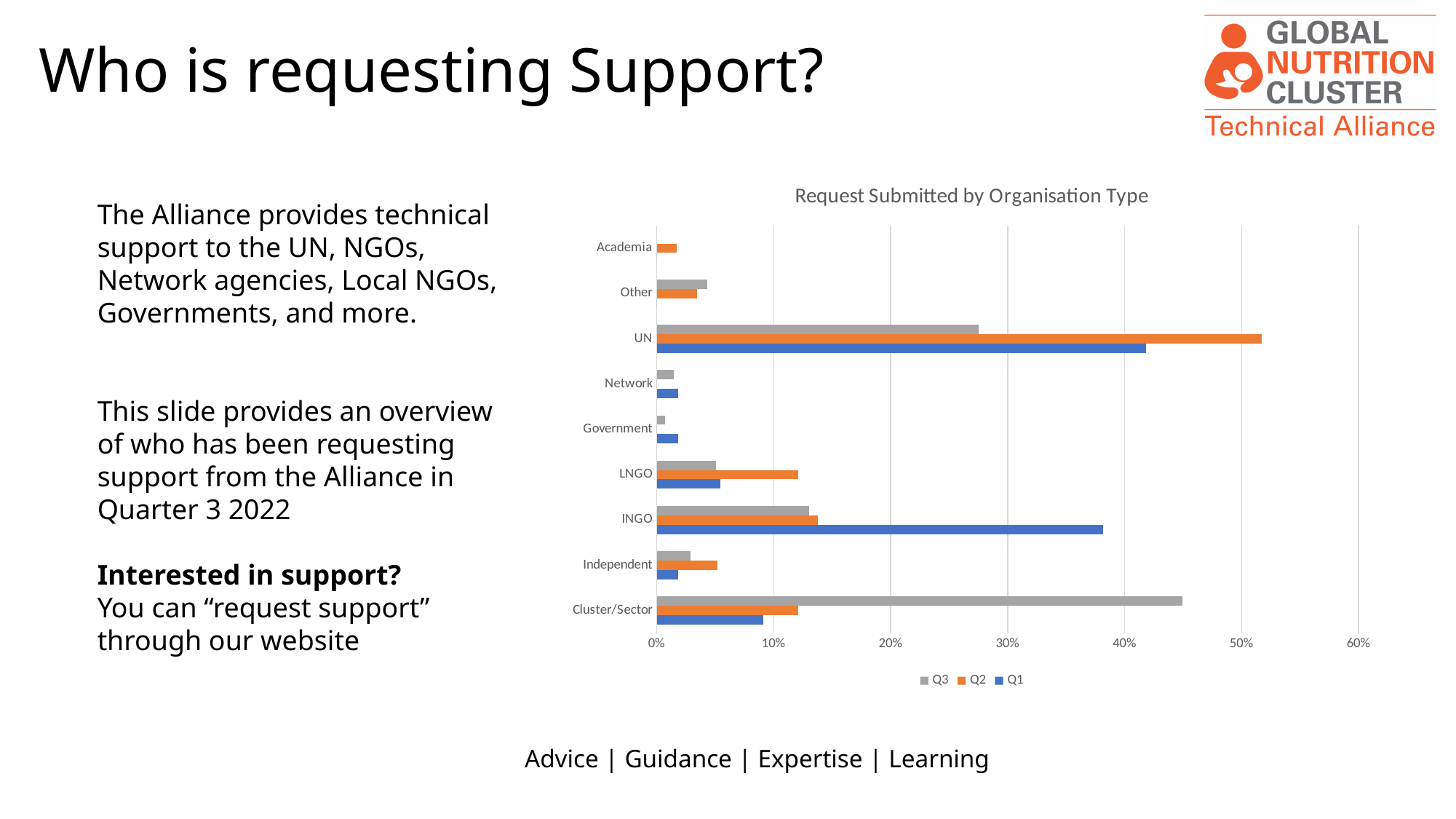
Is the Q1 value for INGO greater or less than 40%? less Which organisation type has the highest Q1 value? UN What is the title of the chart? Request Submitted by Organisation Type How many series does the chart legend list? 3 What type of chart is shown on the slide? Bar chart How many organisation types are shown on the chart? 9 Which organisation type has the highest Q2 value? UN Is the Q3 value for Cluster/Sector greater or less than 40%? greater Is the Q3 value for UN greater or less than 30%? less Which organisation type has the highest Q3 value? Cluster/Sector For UN, which is larger: the Q2 value or the Q1 value? Q2